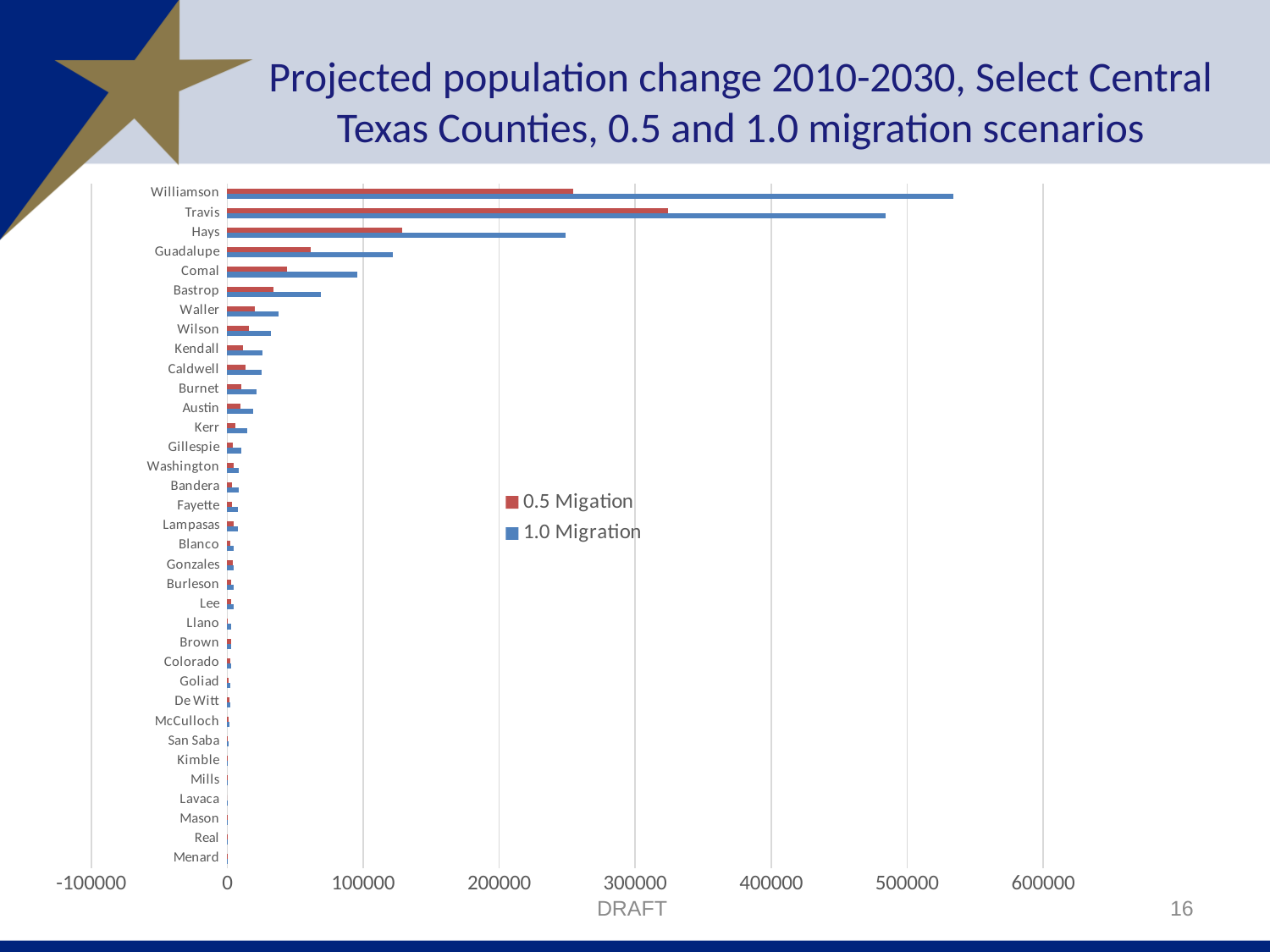
How many series does the legend list? 2 Which is larger for the 0.5 Migration series: Travis or Williamson? Travis What colour represents the 0.5 Migration series? Red What kind of chart is shown on the slide? Bar chart Which county has the highest value for the 0.5 Migration series? Travis Which is larger for the 1.0 Migration series: Williamson or Travis? Williamson Is the 0.5 Migration value for Travis greater or less than 300000? greater Is the 1.0 Migration value for Travis greater or less than 500000? less Is the 1.0 Migration value for Williamson greater or less than 500000? greater Which county has the highest value for the 1.0 Migration series? Williamson How many counties are plotted on the chart? 35